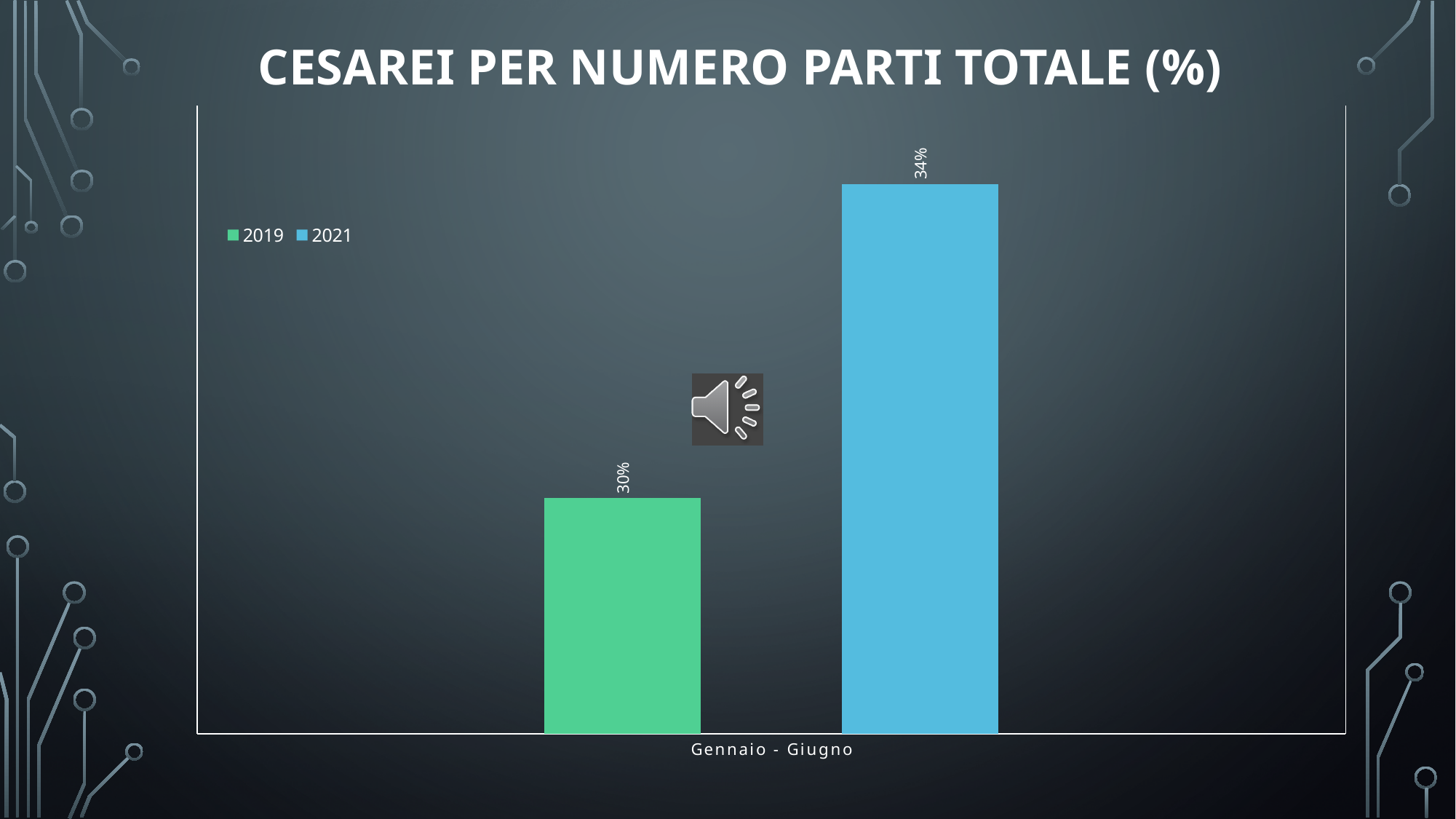
What is the value for 2019 in the chart? 30% Which series has the higher value, 2019 or 2021? 2021 What is the value for 2021 in the chart? 34% What is the title of the chart? CESAREI PER NUMERO PARTI TOTALE (%) Which series has the highest value in the chart? 2021 Which series has the lowest value in the chart? 2019 What is the category label shown on the x axis? Gennaio - Giugno What is the difference between the 2021 value and the 2019 value? 4% How many categories are shown on the x axis? 1 How many series does the legend list? 2 What kind of chart is shown on the slide? Bar chart